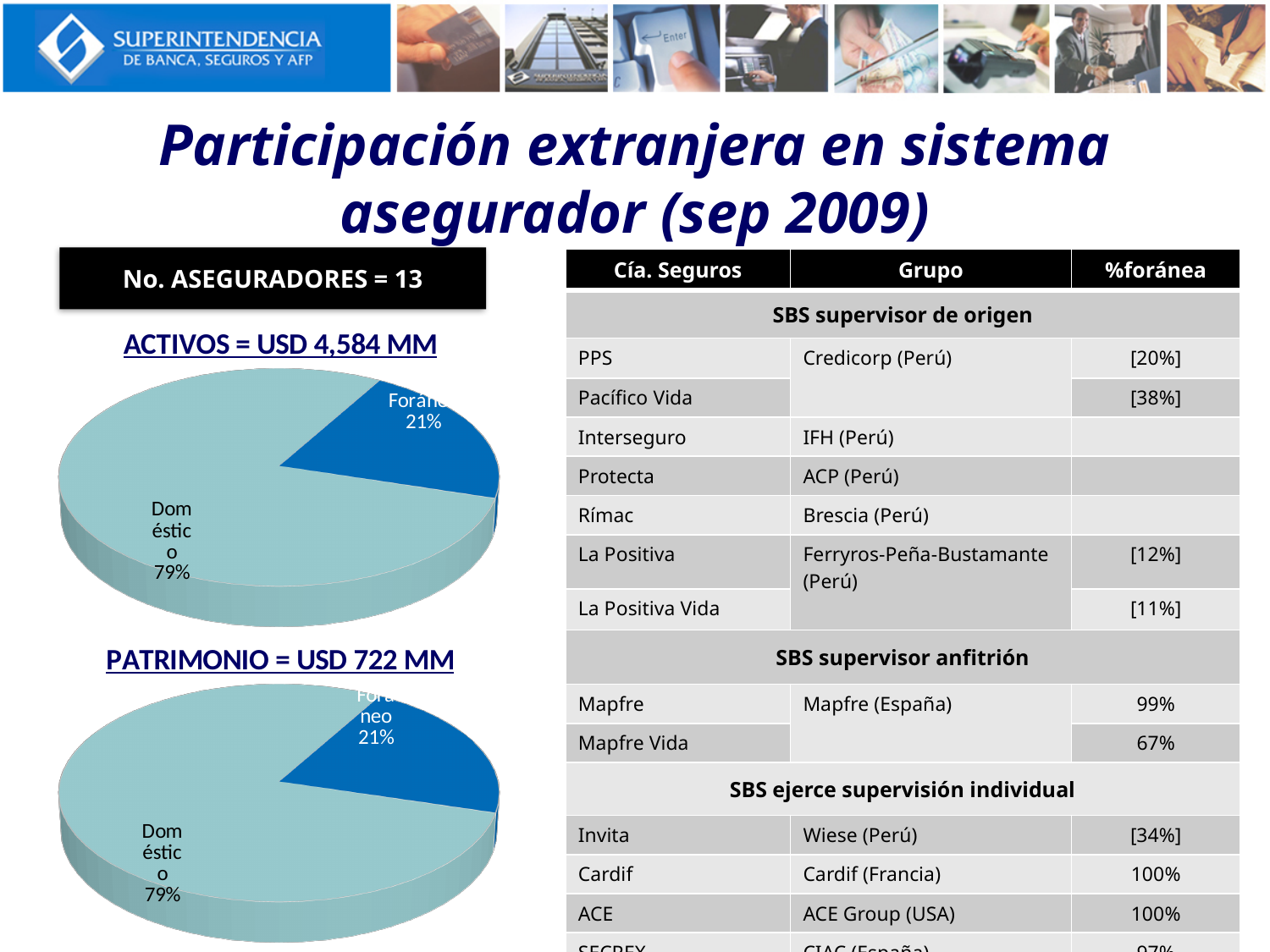
What kind of chart is the ACTIVOS = USD 4,584 MM chart? Pie chart In the ACTIVOS = USD 4,584 MM chart, how many slices does the pie have? 2 What kind of chart is the PATRIMONIO = USD 722 MM chart? Pie chart In the ACTIVOS = USD 4,584 MM chart, which is larger, the Doméstico slice or the Foráneo slice? Doméstico In the ACTIVOS = USD 4,584 MM chart, what share of the pie is Doméstico? 79% In the PATRIMONIO = USD 722 MM chart, what is the difference in percentage points between the Doméstico and Foráneo slices? 58 What is the title of the lower pie chart on the slide? PATRIMONIO = USD 722 MM In the PATRIMONIO = USD 722 MM chart, which slice is the smallest? Foráneo In the PATRIMONIO = USD 722 MM chart, what share of the pie is Doméstico? 79% In the ACTIVOS = USD 4,584 MM chart, which slice is the largest? Doméstico In the ACTIVOS = USD 4,584 MM chart, what share of the pie is Foráneo? 21%